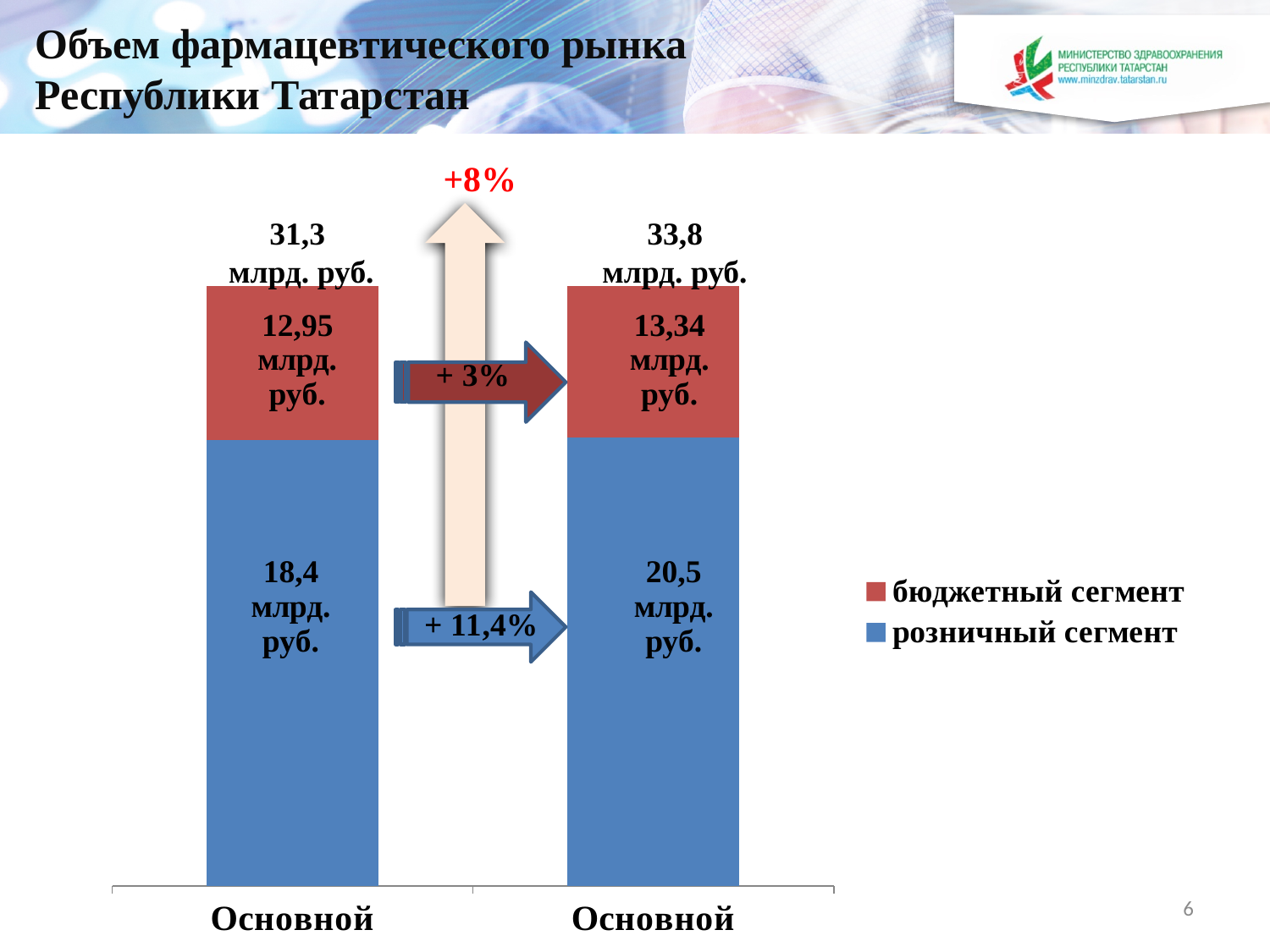
What is the value of the бюджетный сегмент in the left bar? 12,95 млрд. руб. How many series does the legend list? 2 Which bar has the larger розничный сегмент value, the left or the right? right What kind of chart is shown on the slide? stacked bar chart What is the value of the розничный сегмент in the left bar? 18,4 млрд. руб. What is the difference between the розничный сегмент values of the right and left bars? 2,1 млрд. руб. What is the value of the бюджетный сегмент in the right bar? 13,34 млрд. руб. What is the value of the розничный сегмент in the right bar? 20,5 млрд. руб. What is the total of the right stacked bar? 33,8 млрд. руб. What is the total of the left stacked bar? 31,3 млрд. руб. What percentage growth is shown by the large vertical arrow between the two bars? +8% How many bars are plotted in the chart? 2